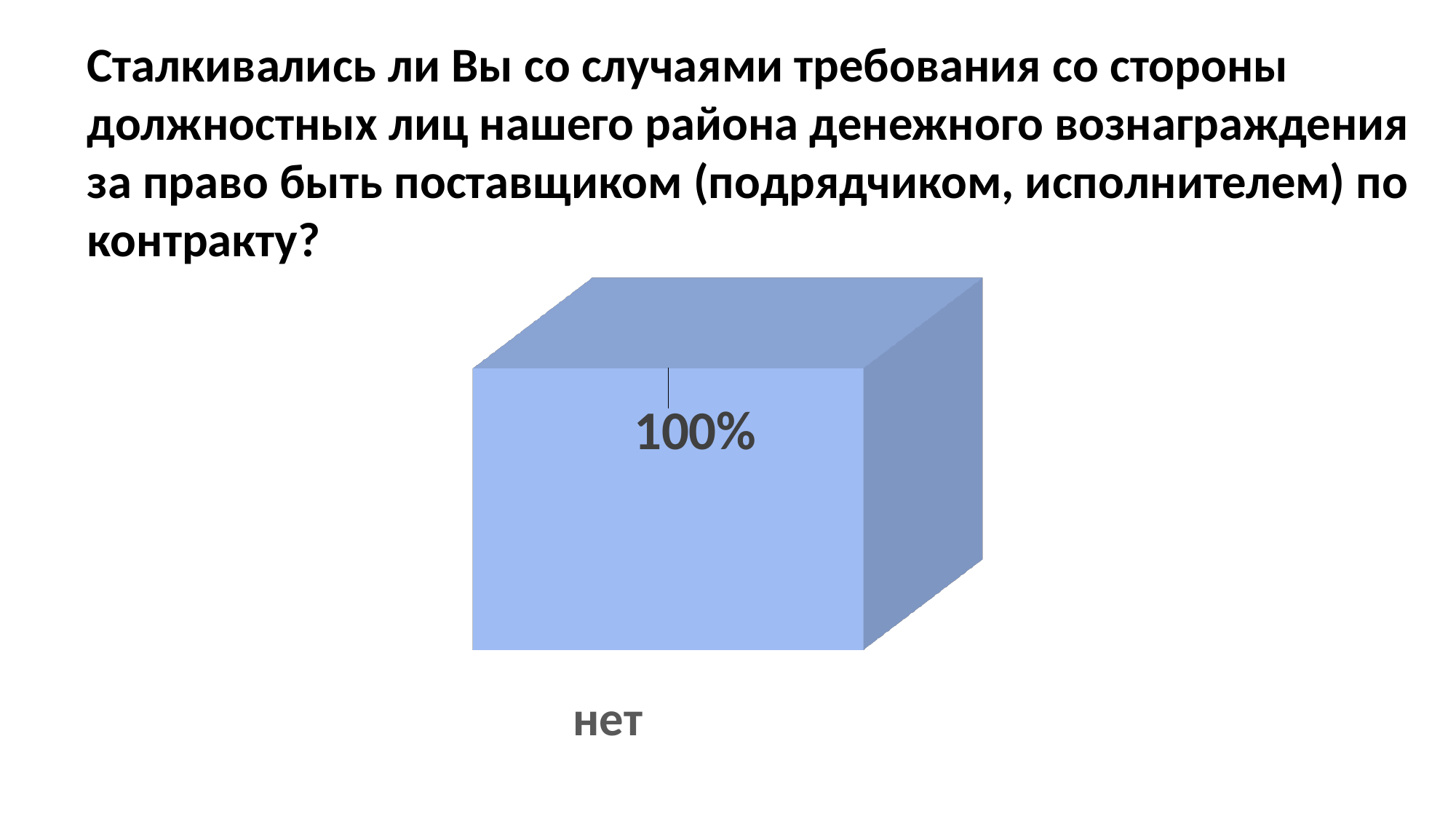
What kind of chart is shown on the slide? bar chart What is the label of the only category shown in the chart? нет What value is shown for the category "нет"? 100% Is the value for "нет" greater or less than 50%? greater What colour is the bar in the chart? blue How many categories are plotted in the chart? 1